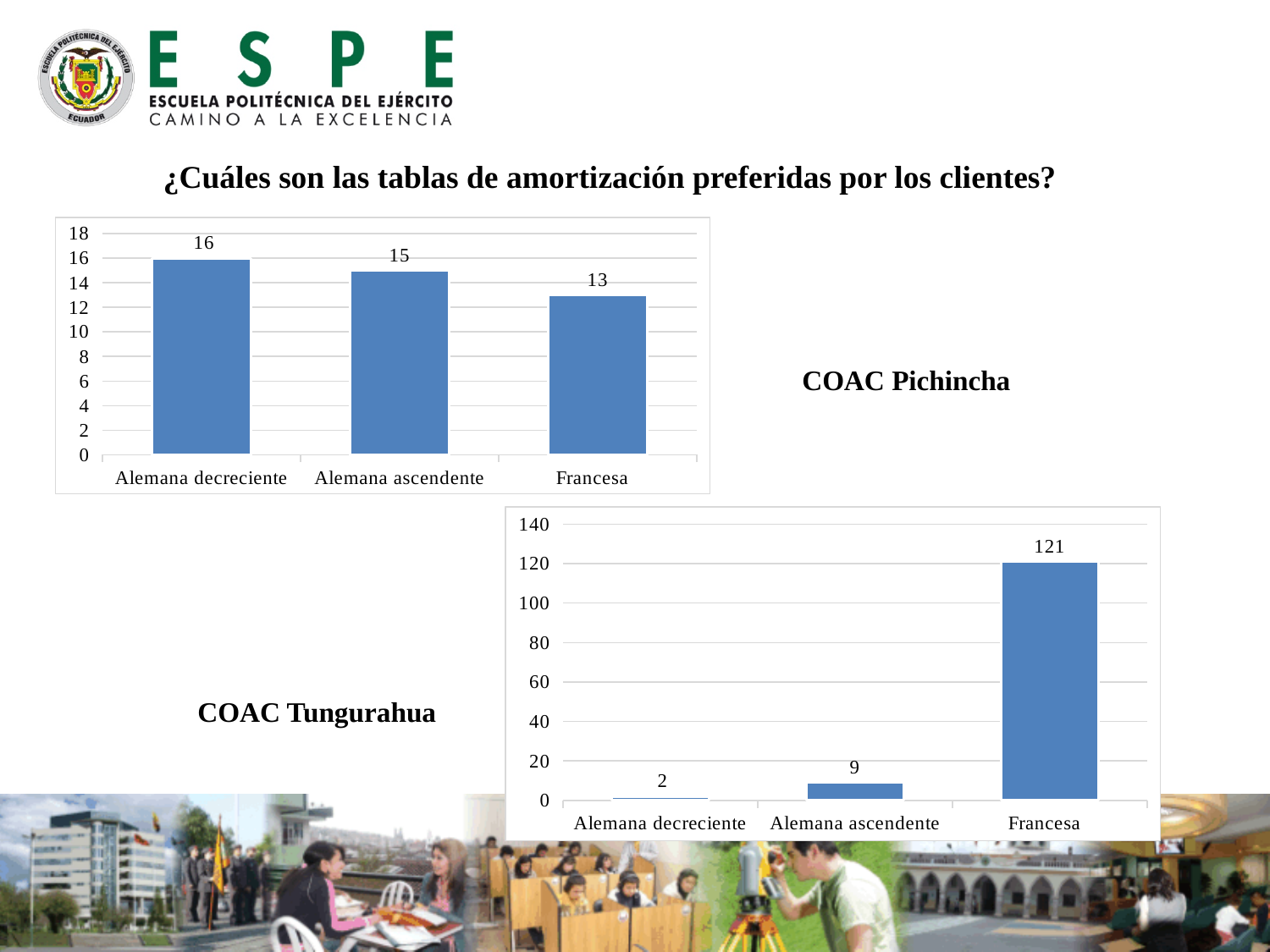
In the COAC Pichincha chart, what is the value for Francesa? 13 How many categories are shown in the COAC Tungurahua chart? 3 In the COAC Tungurahua chart, is the value for Alemana ascendente larger or smaller than the value for Alemana decreciente? larger In the COAC Tungurahua chart, what is the difference between Francesa and Alemana ascendente? 112 In the COAC Tungurahua chart, what is the value for Francesa? 121 In the COAC Pichincha chart, which category has the highest value? Alemana decreciente In the COAC Tungurahua chart, which category has the highest value? Francesa In the COAC Pichincha chart, what is the value for Alemana decreciente? 16 In the COAC Pichincha chart, what is the difference between Alemana decreciente and Francesa? 3 In the COAC Pichincha chart, which category has the lowest value? Francesa In the COAC Tungurahua chart, what is the value for Alemana decreciente? 2 What kind of chart is the COAC Pichincha chart? bar chart